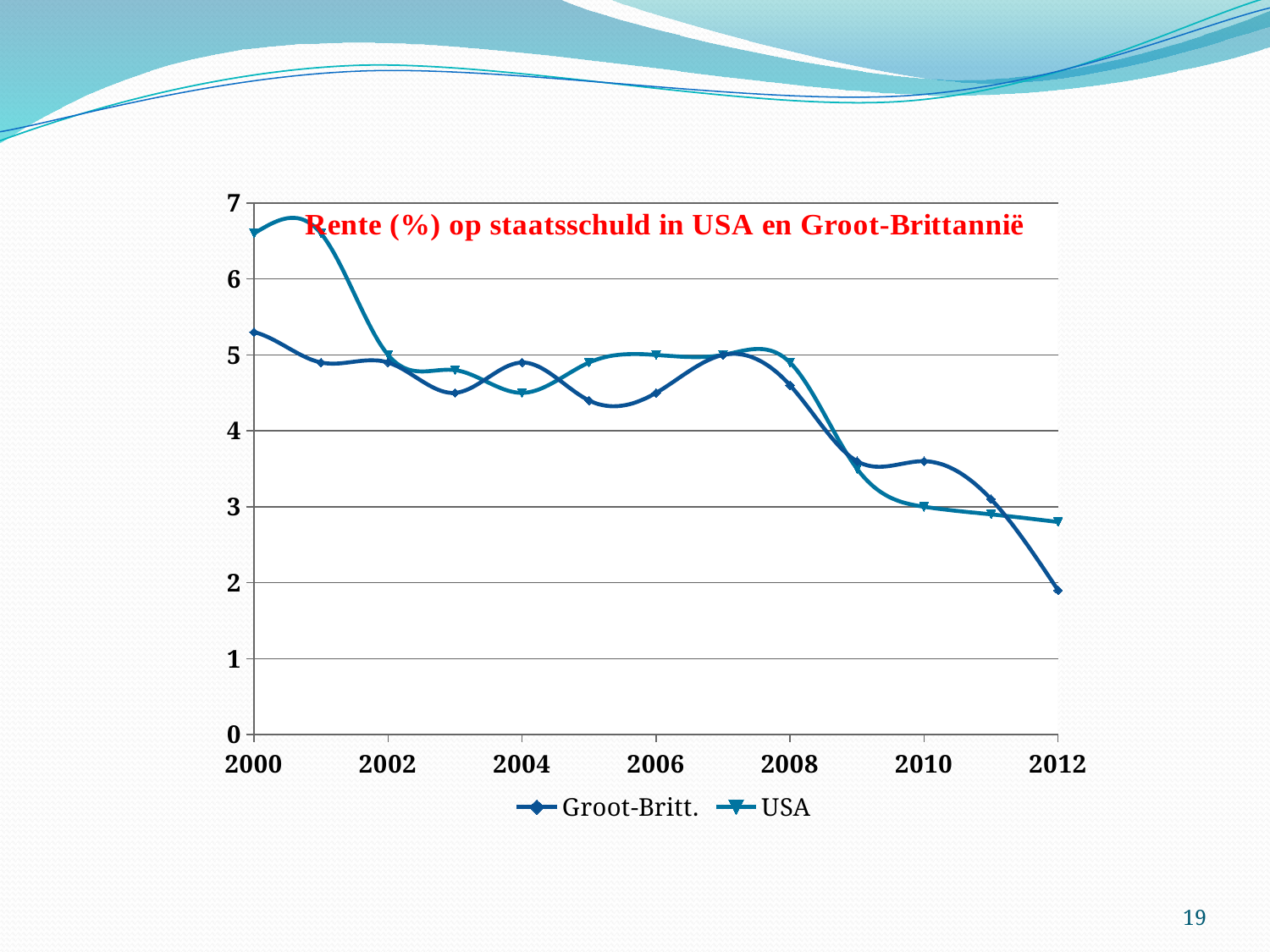
What kind of chart is shown on the slide? line chart What is the title of the chart? Rente (%) op staatsschuld in USA en Groot-Brittannië In 2000, which series has the higher value, Groot-Britt. or USA? USA In which year is the Groot-Britt. series at its lowest? 2012 Which two series are listed in the legend? Groot-Britt. and USA Overall, do the values for USA rise or fall from 2000 to 2012? fall Is the value for USA in 2000 greater or less than 6? greater How many years are plotted along the x axis? 13 How many series does the legend list? 2 In 2012, which series has the higher value, Groot-Britt. or USA? USA